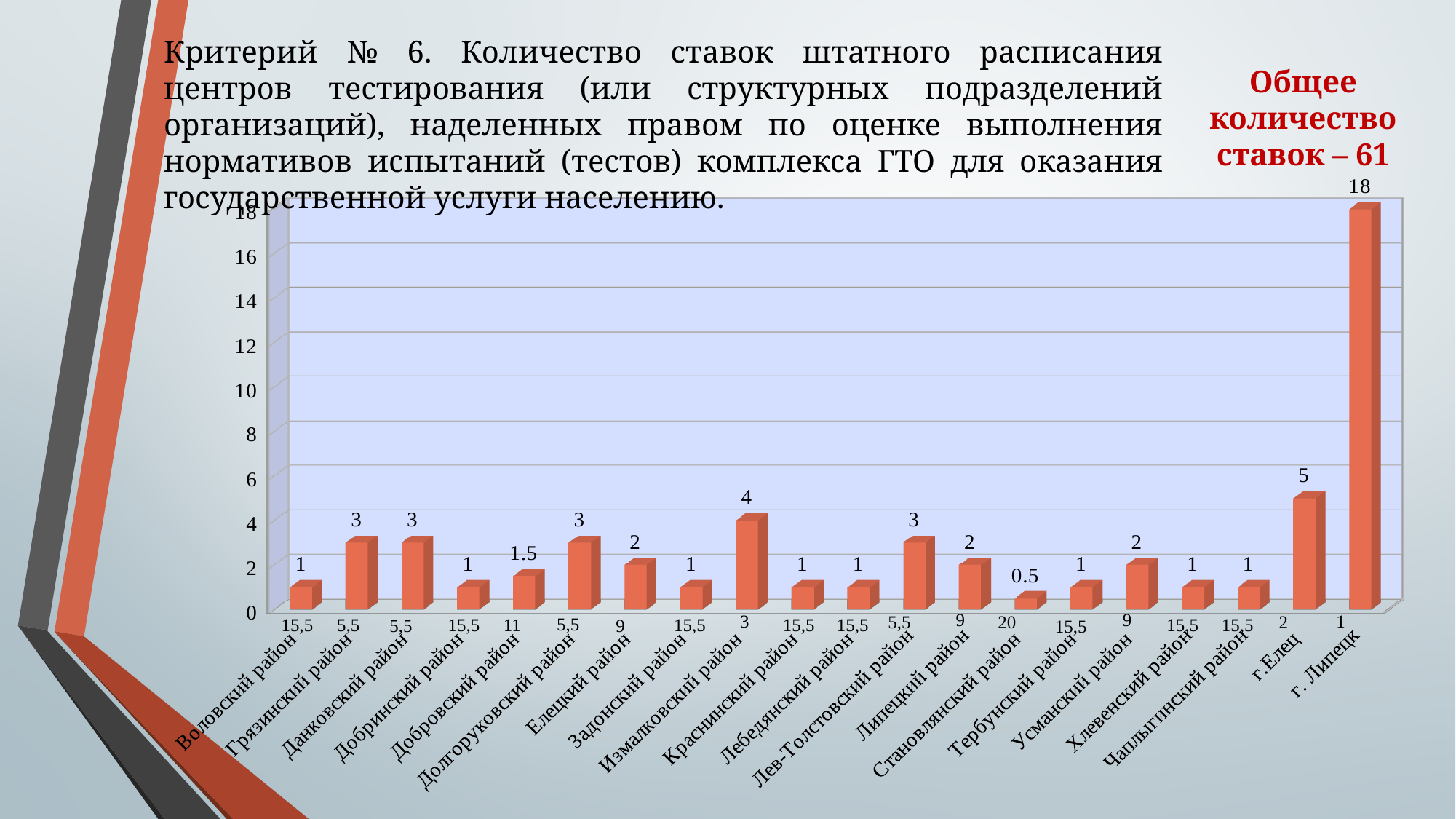
What is the value for Добровский район? 1.5 Which is larger, the value for Измалковский район or the value for Липецкий район? Измалковский район What is the value for г.Елец? 5 What is the difference between the values for г. Липецк and г.Елец? 13 What is the value for Становлянский район? 0.5 What is the value for г. Липецк? 18 Which category has the highest value? г. Липецк Is the value for г. Липецк greater or less than 10? greater How many categories are shown on the x axis of the chart? 20 Which category has the lowest value? Становлянский район What is the value for Измалковский район? 4 What kind of chart is shown on the slide? bar chart